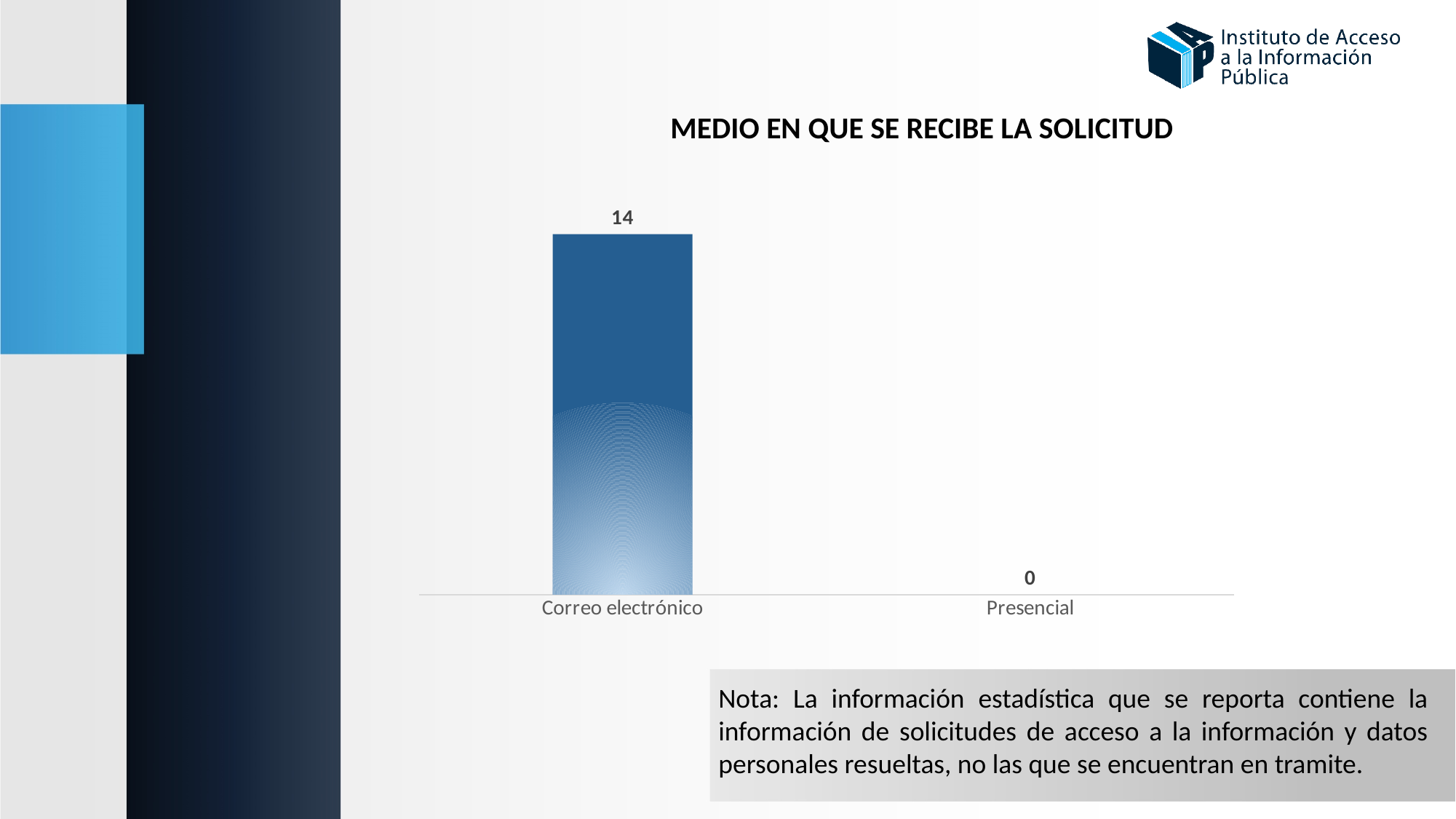
What is the title of the chart? MEDIO EN QUE SE RECIBE LA SOLICITUD What is the difference between the values for Correo electrónico and Presencial? 14 Which category has the lowest value? Presencial What is the total of the values for Correo electrónico and Presencial? 14 What is the value for Presencial? 0 How many categories are shown on the x axis? 2 What kind of chart is shown on the slide? Bar chart Do the values rise or fall from left to right along the x axis? Fall What is the value for Correo electrónico? 14 Which is larger, the value for Correo electrónico or the value for Presencial? Correo electrónico Which category has the highest value? Correo electrónico